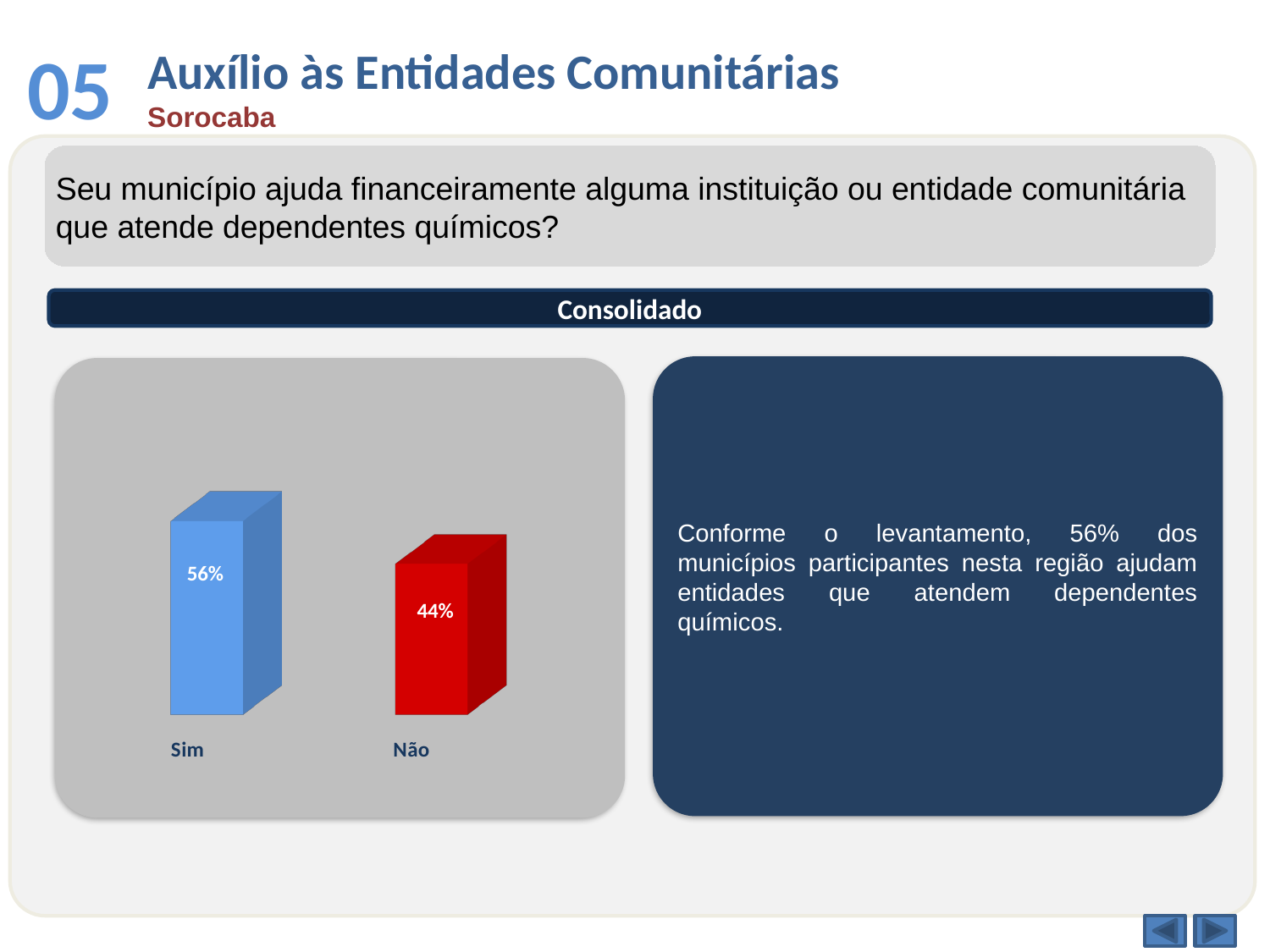
What is the total of the values for Sim and Não? 100% Which category has the lowest value? Não How many categories are shown in the chart? 2 What colour is the bar for Não? Red What colour is the bar for Sim? Blue What is the value for Sim? 56% What is the value for Não? 44% What kind of chart is shown on the slide? Bar chart What is the difference between the values for Sim and Não? 12% Which category has the highest value? Sim Which is larger, the value for Sim or the value for Não? Sim